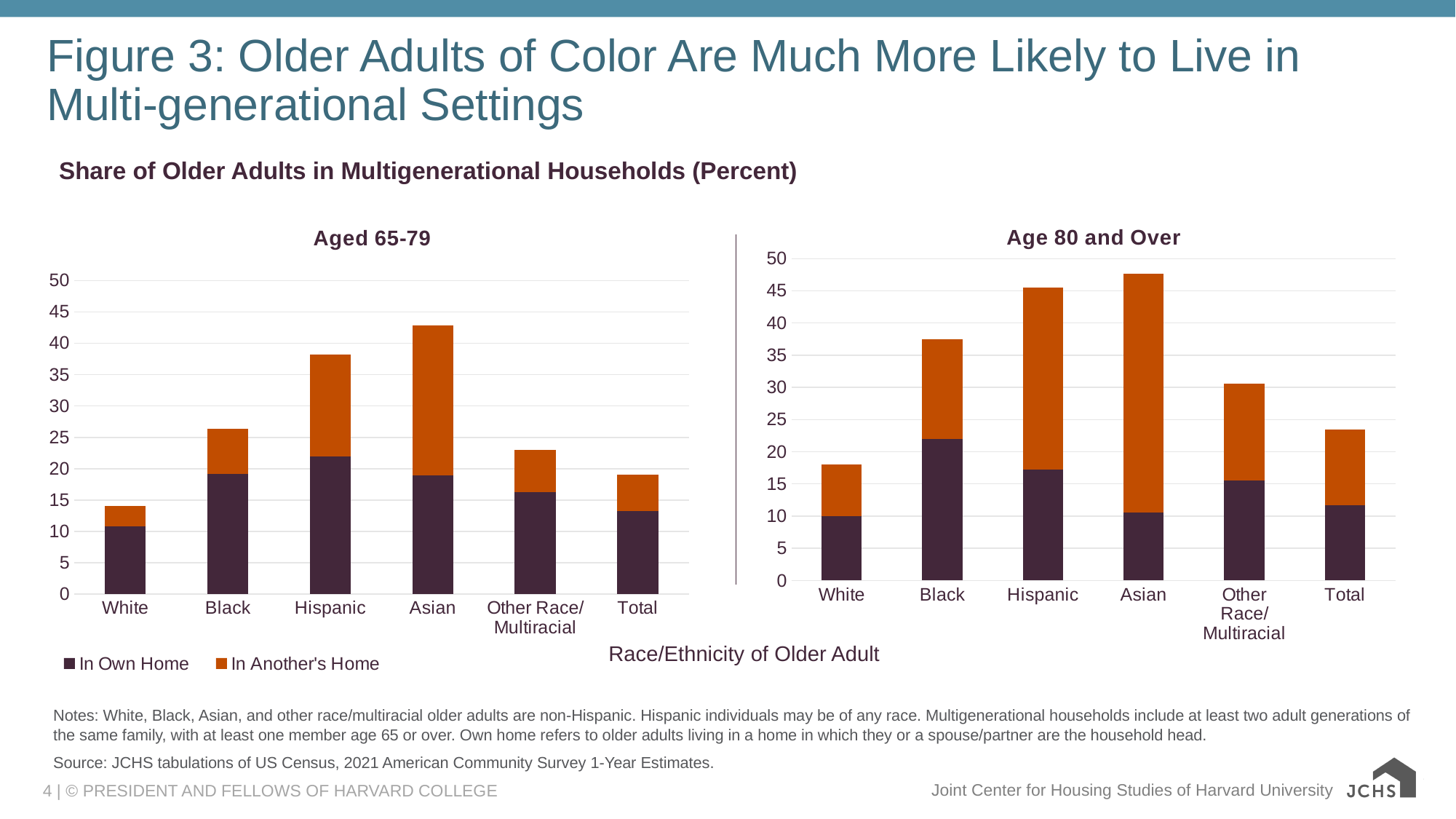
How many series does the legend list? 2 In the "Aged 65-79" chart, which category has the tallest stacked bar? Asian In the "Aged 65-79" chart, which has the taller stacked bar, Hispanic or Black? Hispanic In the "Age 80 and Over" chart, is the total stacked value for Black greater or less than 35? greater In the "Aged 65-79" chart, which category has the shortest stacked bar? White How many race/ethnicity categories are shown in the "Age 80 and Over" chart? 6 In the "Age 80 and Over" chart, is the total stacked value for Total greater or less than 25? less In the "Aged 65-79" chart, is the total stacked value for Asian greater or less than 40? greater In the "Age 80 and Over" chart, which category has the shortest stacked bar? White What kind of chart is the "Aged 65-79" chart? Stacked bar chart Which legend entry is shown in orange? In Another's Home